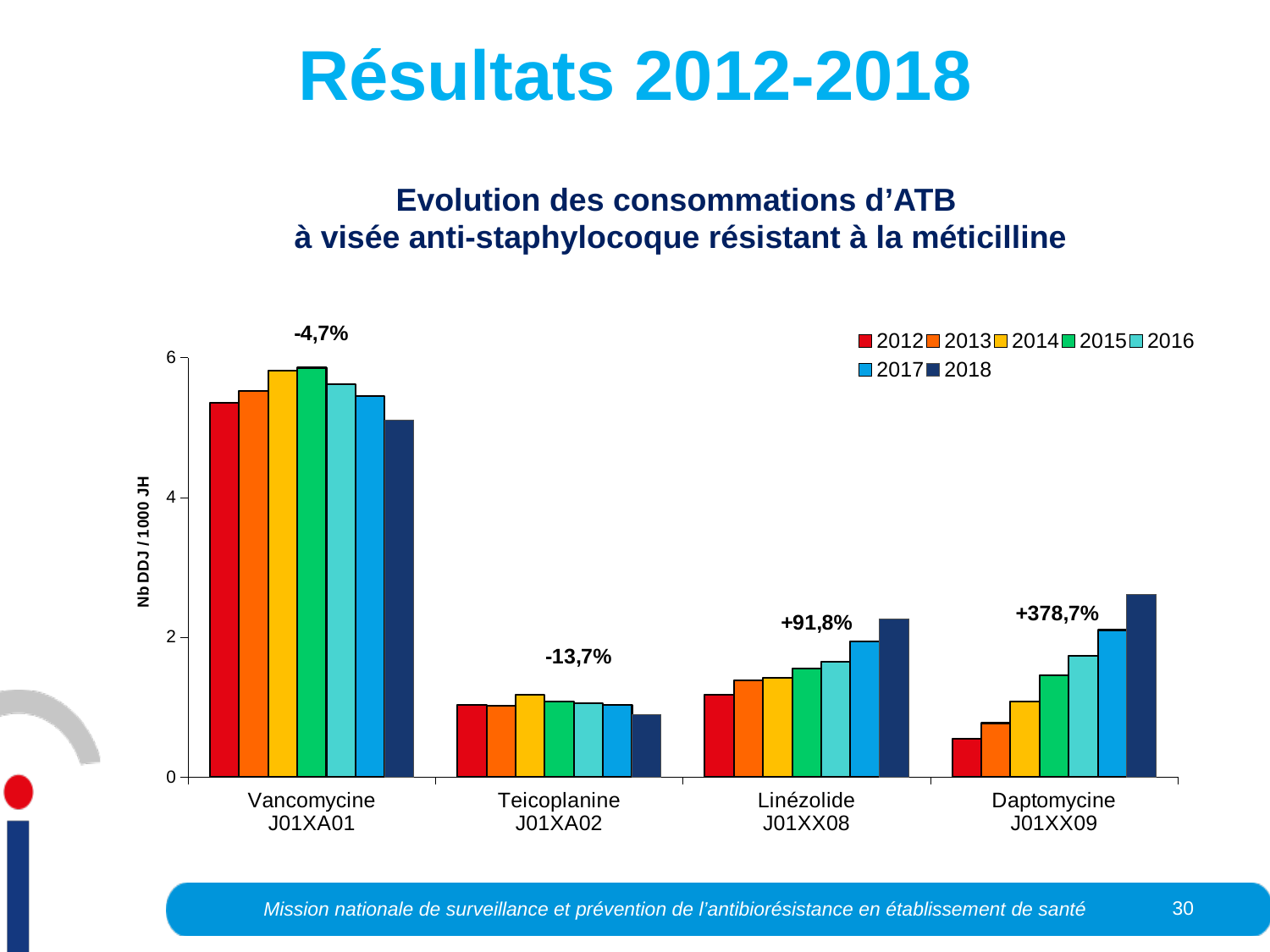
Which antibiotic has the highest consumption values in the chart? Vancomycine J01XA01 What percentage change is printed above the Linézolide J01XX08 bars? +91,8% What kind of chart is shown on the slide? bar chart Do the Daptomycine J01XX09 bars rise or fall from 2012 to 2018? rise How many antibiotic categories are shown on the x axis? 4 Is the 2012 value for Vancomycine J01XA01 greater or less than 4? greater Is the 2018 value for Teicoplanine J01XA02 greater or less than 2? less What is the label on the y axis? Nb DDJ / 1000 JH How many series does the legend list? 7 What percentage change is printed above the Teicoplanine J01XA02 bars? -13,7% What percentage change is printed above the Vancomycine J01XA01 bars? -4,7% What percentage change is printed above the Daptomycine J01XX09 bars? +378,7%